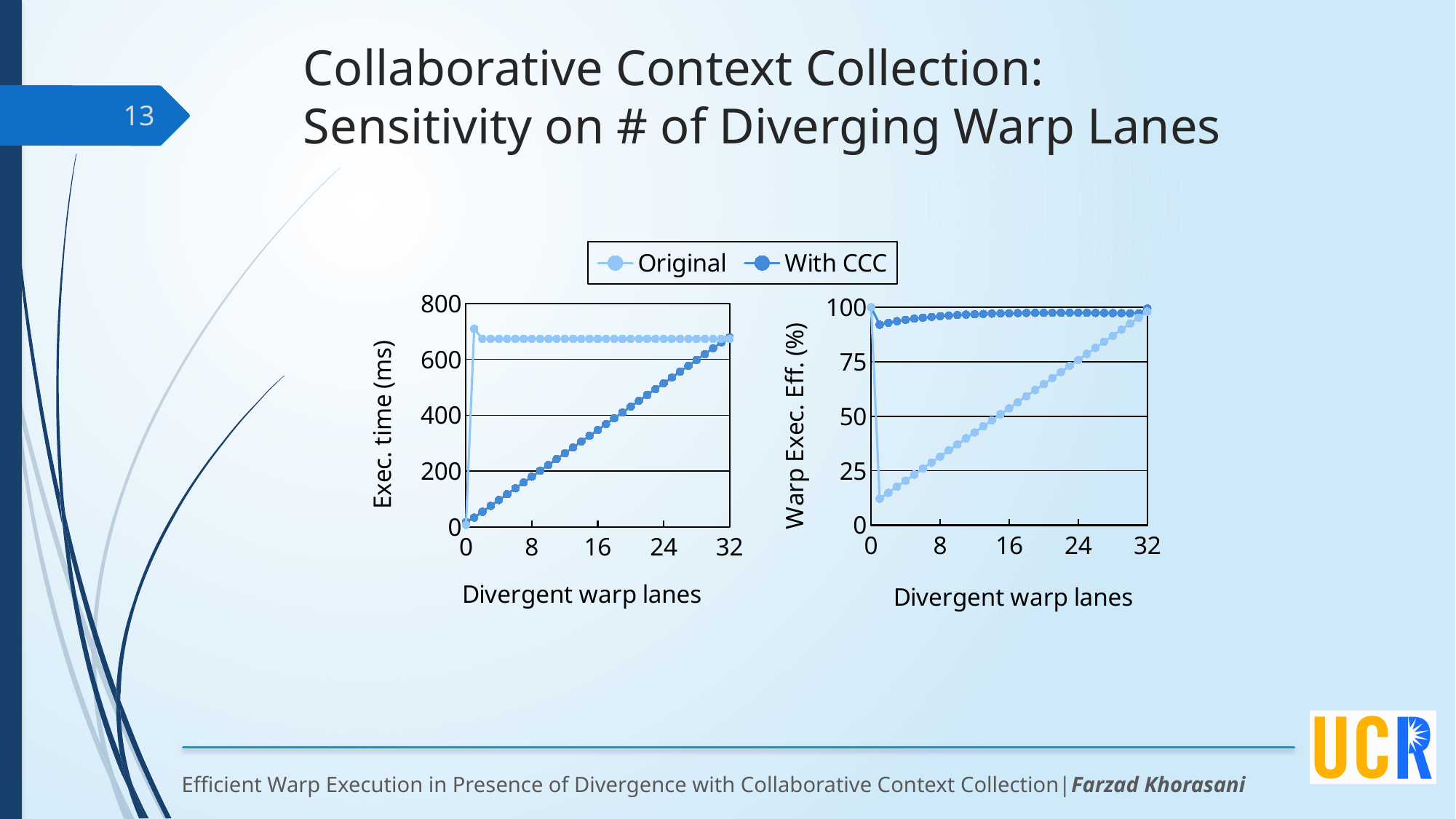
In the left chart (Exec. time), does the With CCC series rise or fall as the number of divergent warp lanes increases? rise In the right chart (Warp Exec. Eff.), is the value for With CCC at 8 divergent warp lanes greater or less than 75? greater What is the y-axis label of the right chart? Warp Exec. Eff. (%) What kind of chart is the left chart (Exec. time vs Divergent warp lanes)? line chart In the right chart (Warp Exec. Eff.), which series has the larger value at 8 divergent warp lanes, Original or With CCC? With CCC In the left chart (Exec. time), which series has the larger value at 16 divergent warp lanes, Original or With CCC? Original In the left chart (Exec. time), is the value for Original at 8 divergent warp lanes greater or less than 600? greater In the right chart (Warp Exec. Eff.), is the value for Original at 2 divergent warp lanes greater or less than 25? less How many series does the legend list? 2 In the right chart (Warp Exec. Eff.), does the Original series rise or fall from 1 to 32 divergent warp lanes? rise